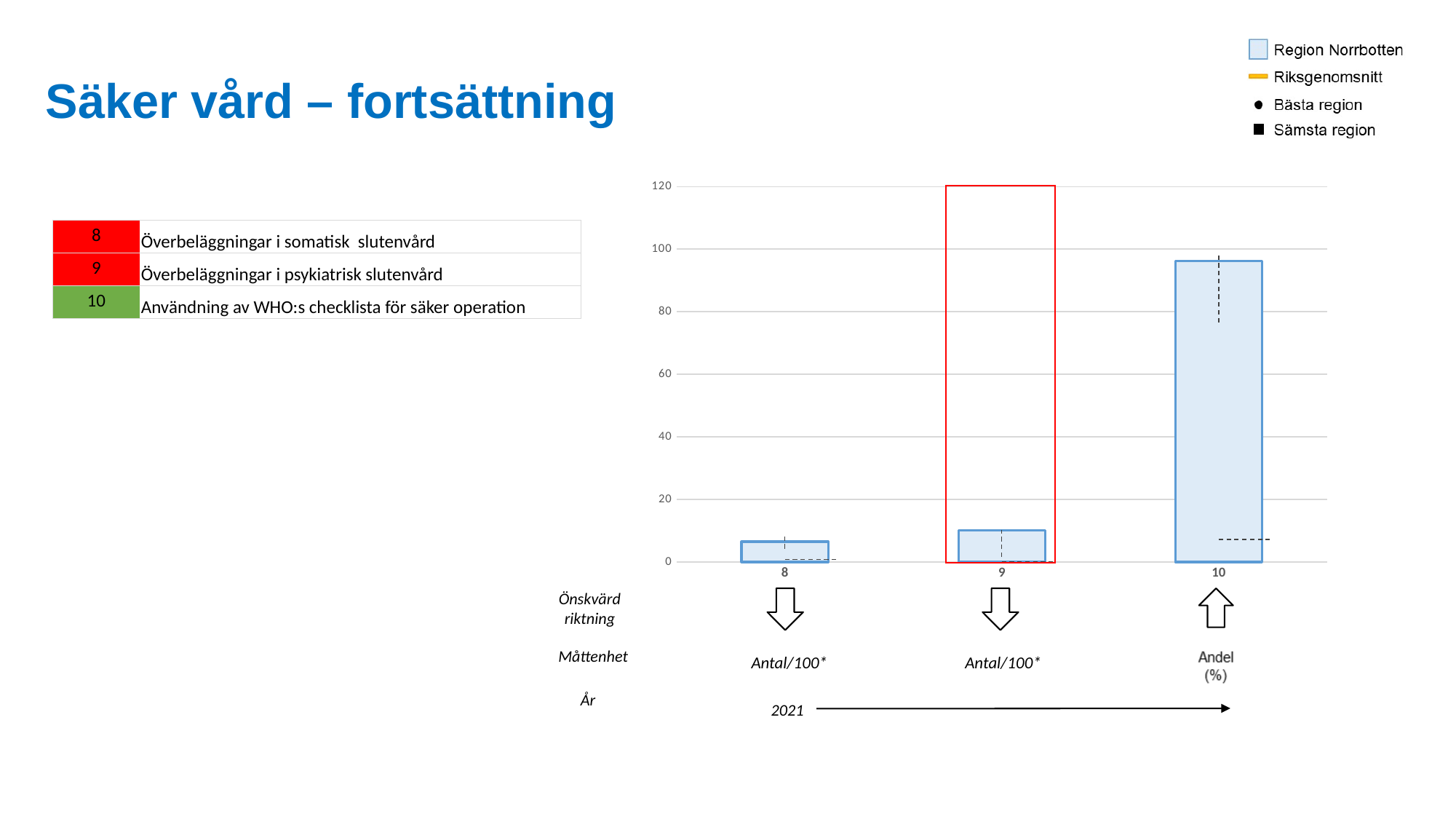
How many entries does the chart legend list? 4 Which legend entry is shown with a light blue filled box? Region Norrbotten Is the value for category 9 greater or less than 20? less Which category has the lowest bar in the chart? 8 Is the value for category 10 greater or less than 80? greater Which category has the highest bar in the chart? 10 How many categories are plotted on the x axis of the chart? 3 Which is larger, the bar for category 10 or the bar for category 8? 10 What kind of chart is shown on the slide? bar chart Do the bar values rise or fall from category 8 to category 10 along the x axis? rise Is the value for category 8 greater or less than 20? less